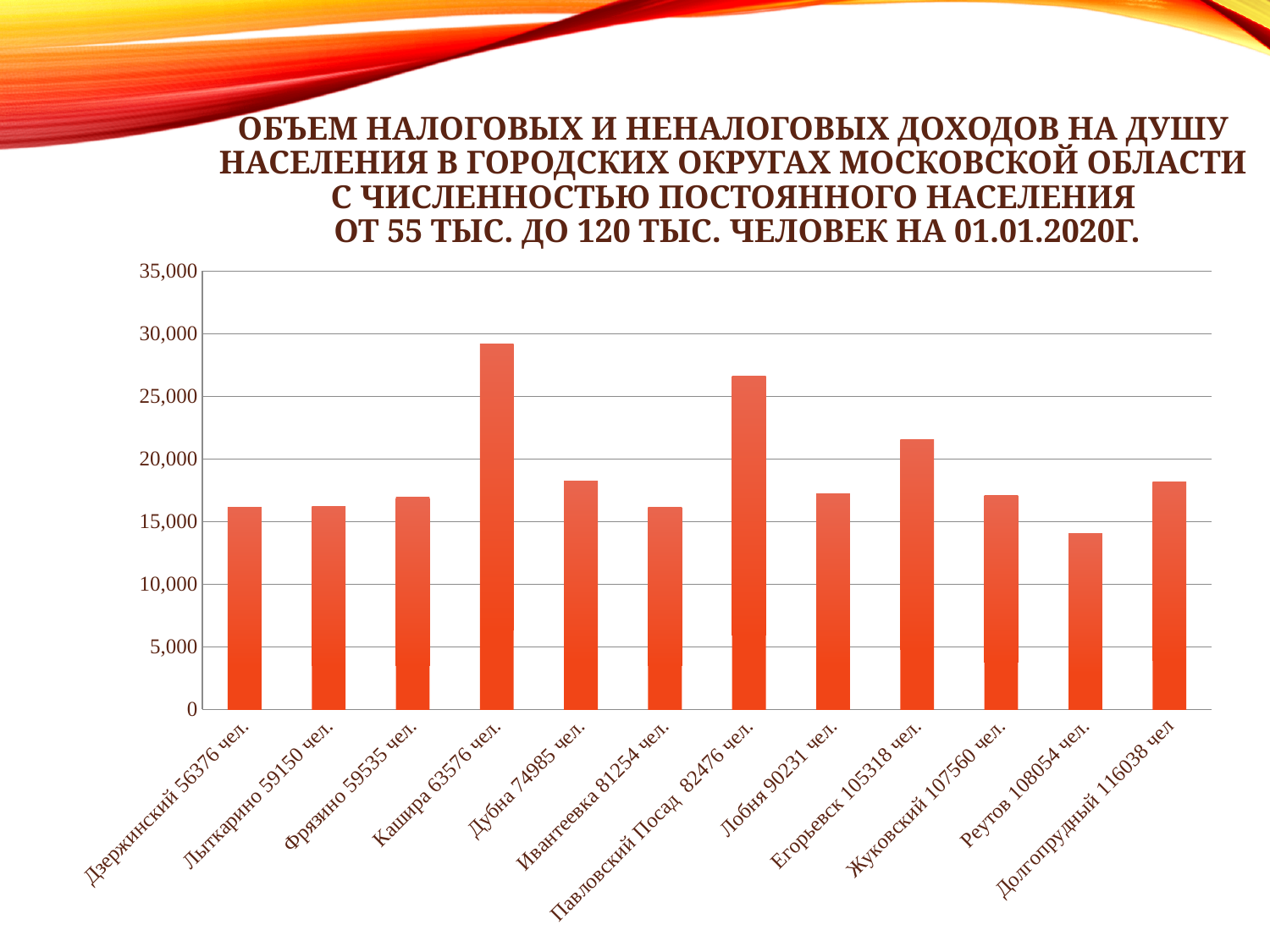
Which has the larger value, Реутов or Лобня? Лобня What kind of chart is shown on the slide? Bar chart Which has the larger value, Егорьевск or Дубна? Егорьевск Which city district has the highest value on the chart? Кашира 63576 чел. Which city district has the lowest value on the chart? Реутов 108054 чел. Is the value for Кашира greater or less than 25,000? greater Is the value for Реутов greater or less than 15,000? less What is the maximum value shown on the vertical axis of the chart? 35,000 Is the value for Егорьевск greater or less than 20,000? greater Which has the larger value, Кашира or Павловский Посад? Кашира How many city districts (categories) are plotted on the chart? 12